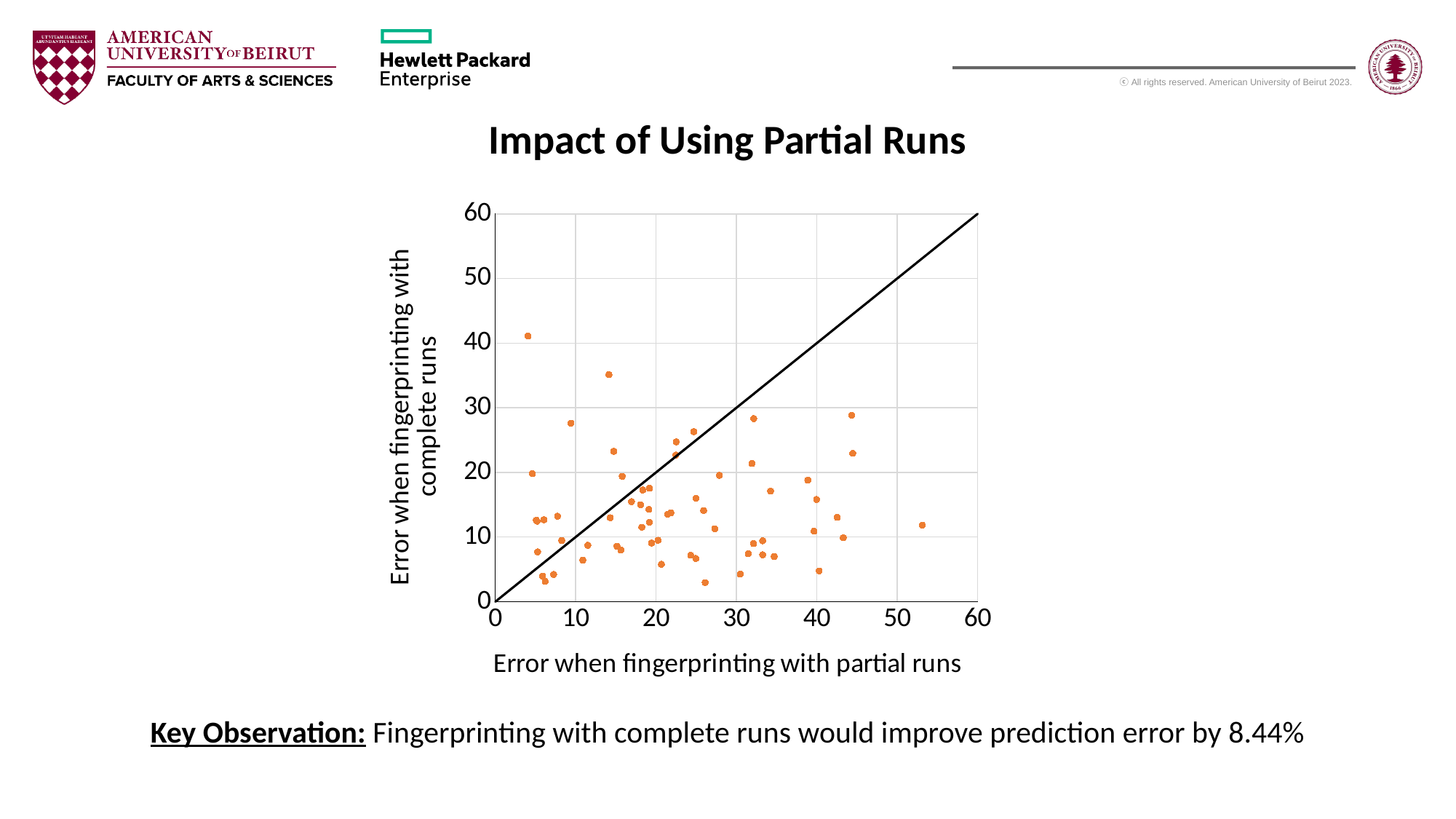
Is the x value of the rightmost point in the chart greater or less than 50? greater Is the y value of the lowest point in the chart greater or less than 10? less What is the title of the chart on the slide? Impact of Using Partial Runs What is the highest tick value shown on the x axis of the chart? 60 Is the x value of the leftmost point in the chart greater or less than 10? less What is the label of the x axis of the chart? Error when fingerprinting with partial runs What kind of chart is shown on the slide? Scatter plot What is the highest tick value shown on the y axis of the chart? 60 Do most of the points in the chart lie above or below the diagonal line? below